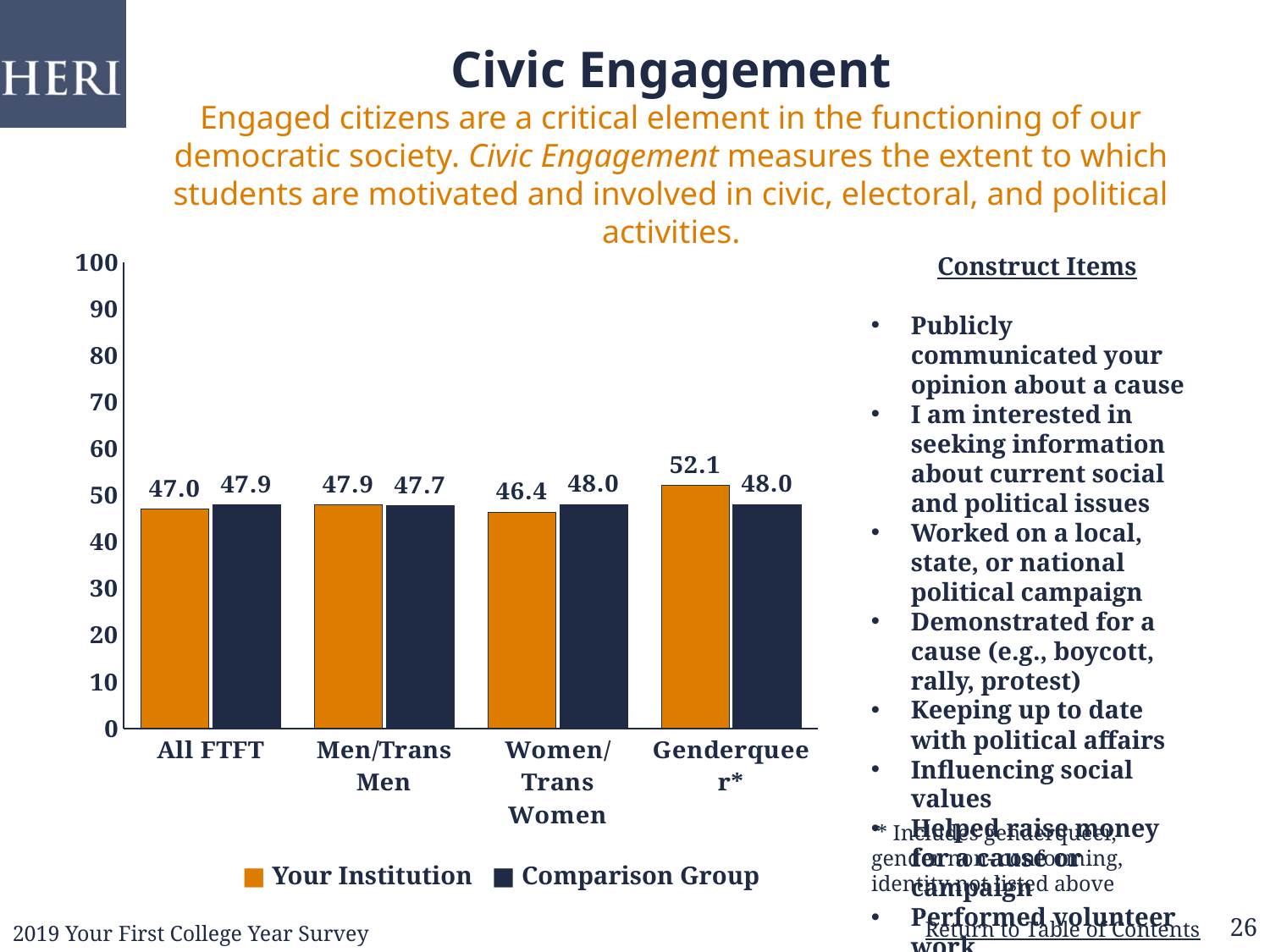
What is the Your Institution value for Genderqueer*? 52.1 What is the Your Institution value for All FTFT? 47.0 Which category has the highest Your Institution value? Genderqueer* Is the Your Institution value for Genderqueer* greater or less than 60? less Which category has the lowest Your Institution value? Women/Trans Women What is the Comparison Group value for Men/Trans Men? 47.7 What is the Comparison Group value for Women/Trans Women? 48.0 For Women/Trans Women, which is larger: the Your Institution value or the Comparison Group value? Comparison Group How many series does the legend list? 2 What is the difference between the Your Institution and Comparison Group values for Genderqueer*? 4.1 What kind of chart is shown on the slide? bar chart How many categories are shown on the x axis? 4